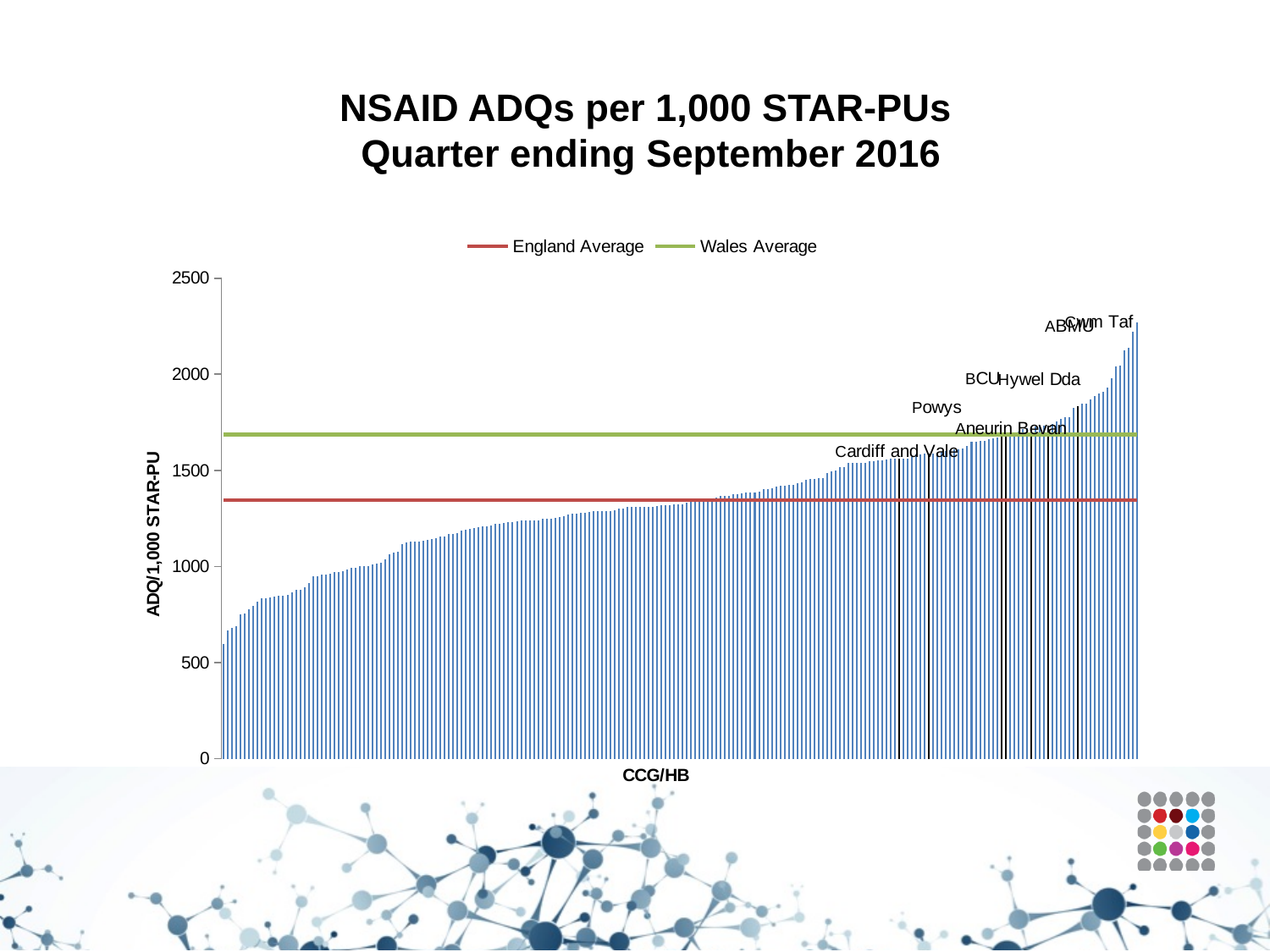
What is the title of the chart? NSAID ADQs per 1,000 STAR-PUs Quarter ending September 2016 Is the value for Powys greater or less than 1500? greater Is the England Average line greater or less than 1500? less Do the bar values rise or fall from left to right along the x axis? rise Which is higher, the Wales Average line or the England Average line? Wales Average Is the value of the lowest bar greater or less than 1000? less What are the two series named in the legend? England Average and Wales Average What kind of chart is shown on the slide? bar chart How many series does the legend list? 2